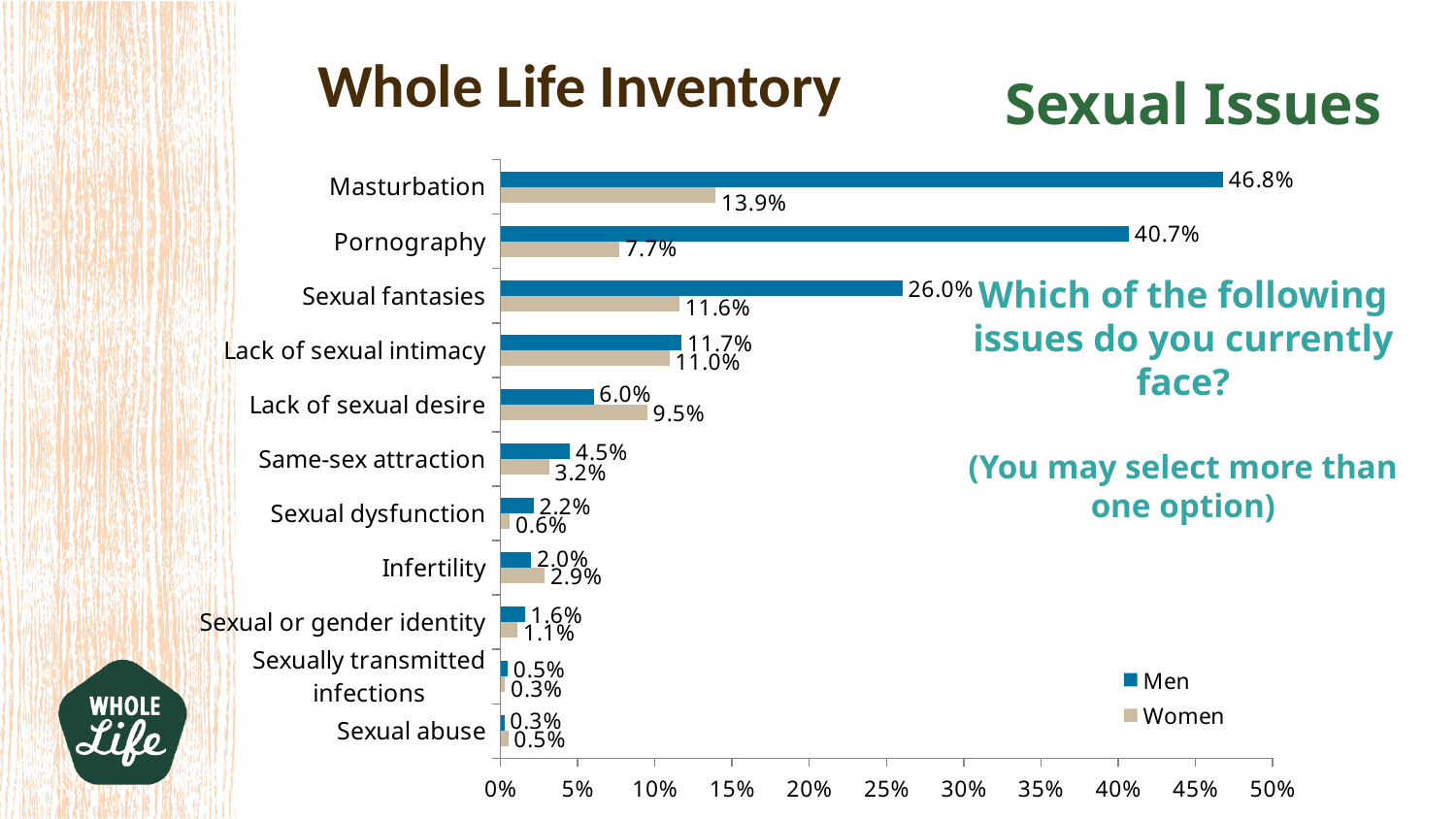
For Lack of sexual desire, which group has the larger value, men or women? Women Which issue has the highest value for men? Masturbation Which issue has the lowest value for women? Sexually transmitted infections What is the value for women for Lack of sexual desire? 9.5% What kind of chart is shown on the slide? Bar chart What percentage of men report Masturbation as an issue they currently face? 46.8% How many series does the legend list? 2 Which colour represents Women in the chart? Tan (beige) Is the men's value for Pornography greater or less than 40%? greater How many issue categories are shown on the chart? 11 What is the difference between the men's and women's values for Masturbation? 32.9% What percentage of women report Pornography as an issue they currently face? 7.7%